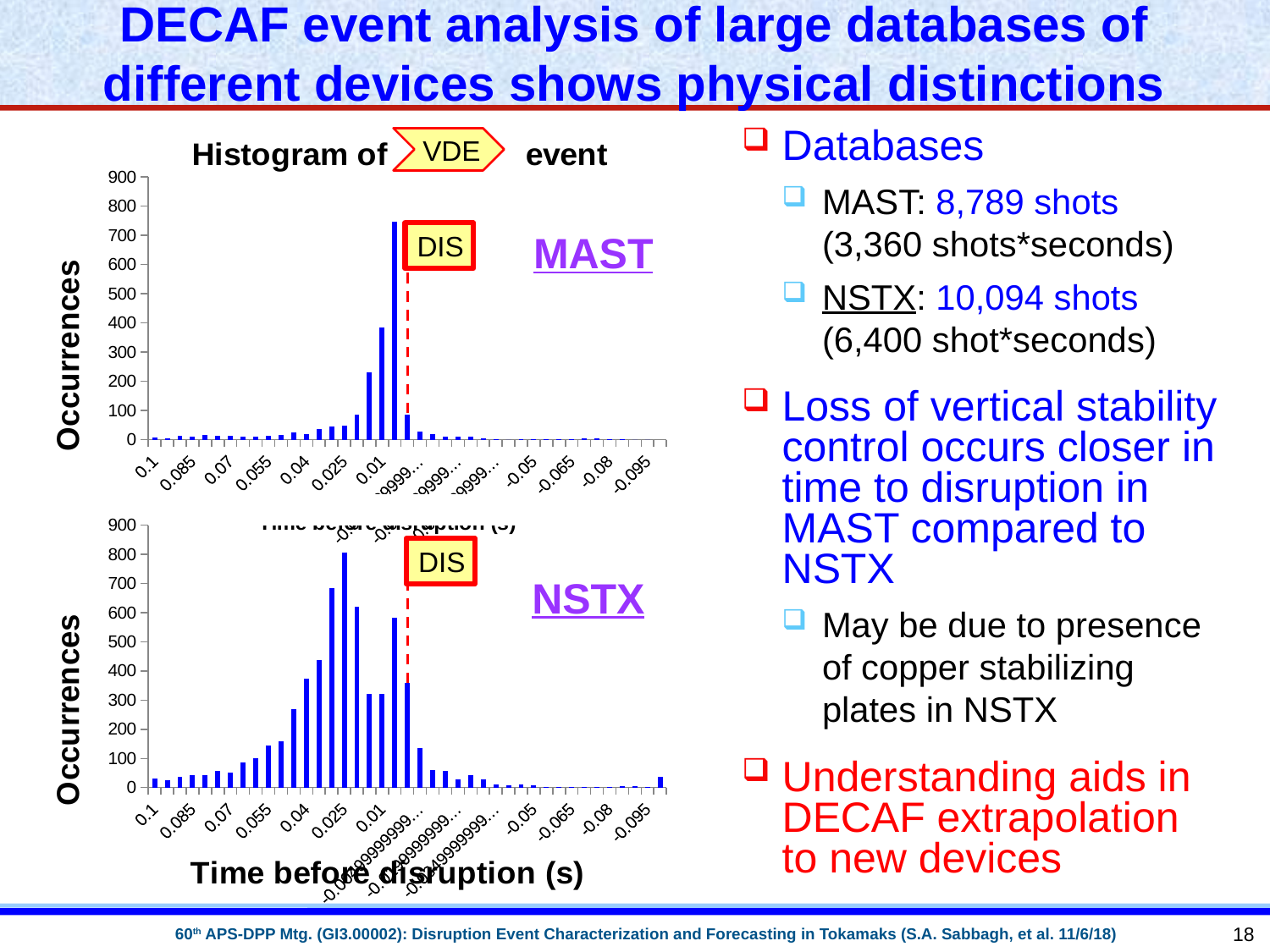
In the bottom (NSTX) chart, is the value of the bar at -0.095 greater or less than 100? less What is the y-axis label of the bottom (NSTX) chart? Occurrences What kind of chart is the bottom (NSTX) chart? bar chart In the bottom (NSTX) chart, is the value of the tallest bar greater or less than 700? greater What is the highest tick value shown on the y axis of the top (MAST) chart? 900 In the bottom (NSTX) chart, is the value of the bar at 0.1 greater or less than 100? less What kind of chart is the top (MAST) chart? bar chart What is the x-axis label of the bottom (NSTX) chart? Time before disruption (s)